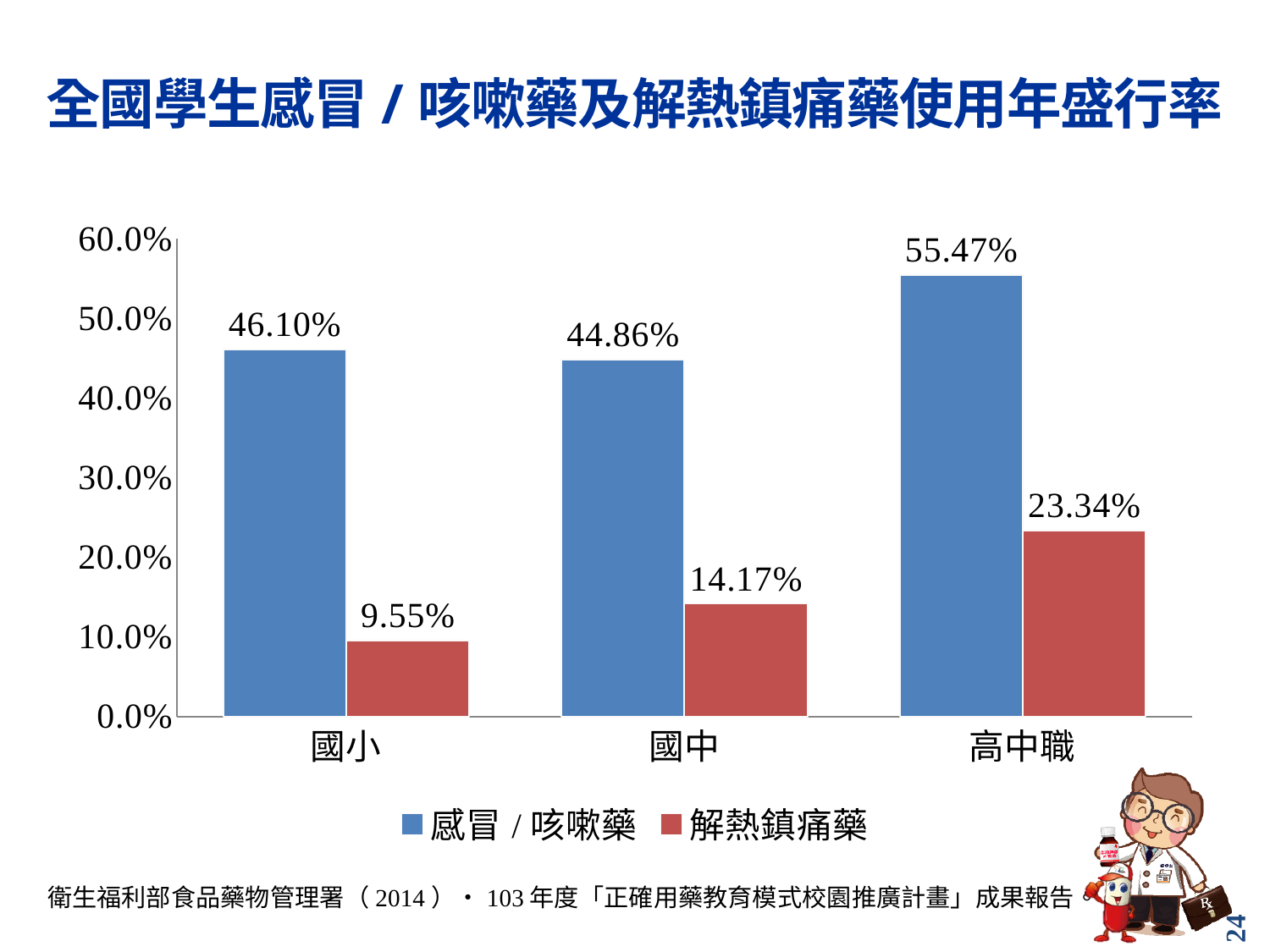
What kind of chart is shown on the slide? bar chart What is the value for 解熱鎮痛藥 in the 國中 category? 14.17% Which category has the highest value for 感冒／咳嗽藥? 高中職 How many categories are shown on the x axis? 3 Is the value for 解熱鎮痛藥 in 國小 greater or less than 10.0%? less What is the value for 解熱鎮痛藥 in the 高中職 category? 23.34% What is the difference between the 感冒／咳嗽藥 and 解熱鎮痛藥 values in the 高中職 category? 32.13% What is the value for 感冒／咳嗽藥 in the 國小 category? 46.10% Which is larger: the 感冒／咳嗽藥 value for 國小 or for 國中? 國小 How many series does the legend list? 2 Do the 解熱鎮痛藥 values rise or fall from 國小 to 高中職? rise Which category has the lowest value for 解熱鎮痛藥? 國小